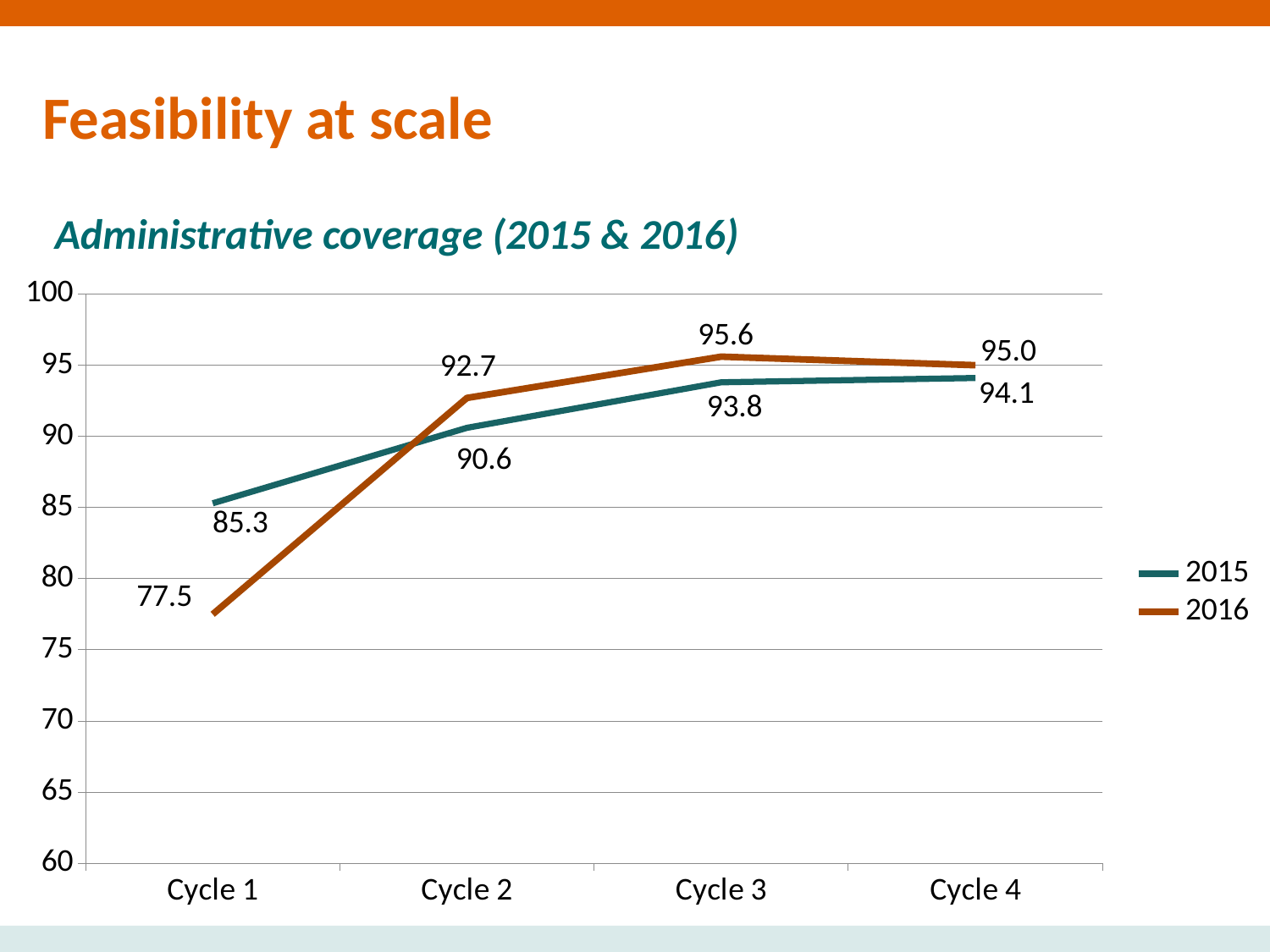
Which cycle has the highest 2016 value? Cycle 3 What is the difference between the 2016 and 2015 values for Cycle 2? 2.1 What is the 2015 value for Cycle 4? 94.1 Which is larger for Cycle 1, the 2015 value or the 2016 value? 2015 What is the 2016 value for Cycle 3? 95.6 Which cycle has the lowest 2015 value? Cycle 1 How many series does the legend list? 2 What kind of chart is shown? Line chart What is the 2016 value for Cycle 1? 77.5 How many cycles are shown on the x axis? 4 Does the 2016 series rise or fall from Cycle 1 to Cycle 3? Rise What is the 2015 value for Cycle 1? 85.3